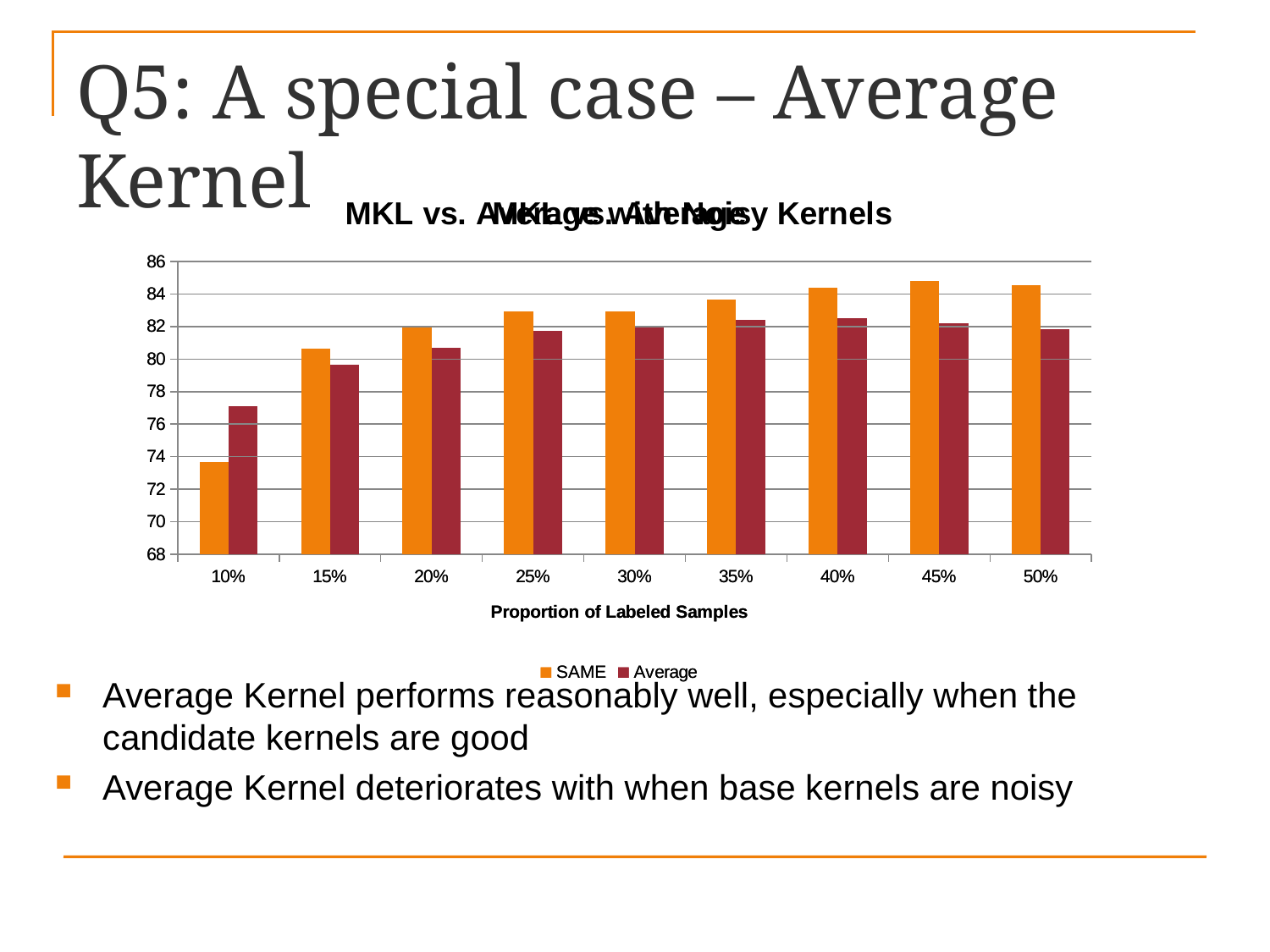
At 50% labeled samples, which series has the larger value, SAME or Average? SAME At which proportion of labeled samples is the Average value lowest? 10% Is the SAME value at 10% labeled samples greater or less than 76? less Is the Average value at 10% labeled samples greater or less than 76? greater How many proportion categories are shown on the x axis of the chart? 9 Which colour represents the SAME series in the chart? orange What is the title of the x axis of the chart? Proportion of Labeled Samples At 10% labeled samples, which series has the larger value, SAME or Average? Average At which proportion of labeled samples is the SAME value lowest? 10% Is the SAME value at 45% labeled samples greater or less than 84? greater What kind of chart is shown on the slide? bar chart How many series does the chart's legend list? 2